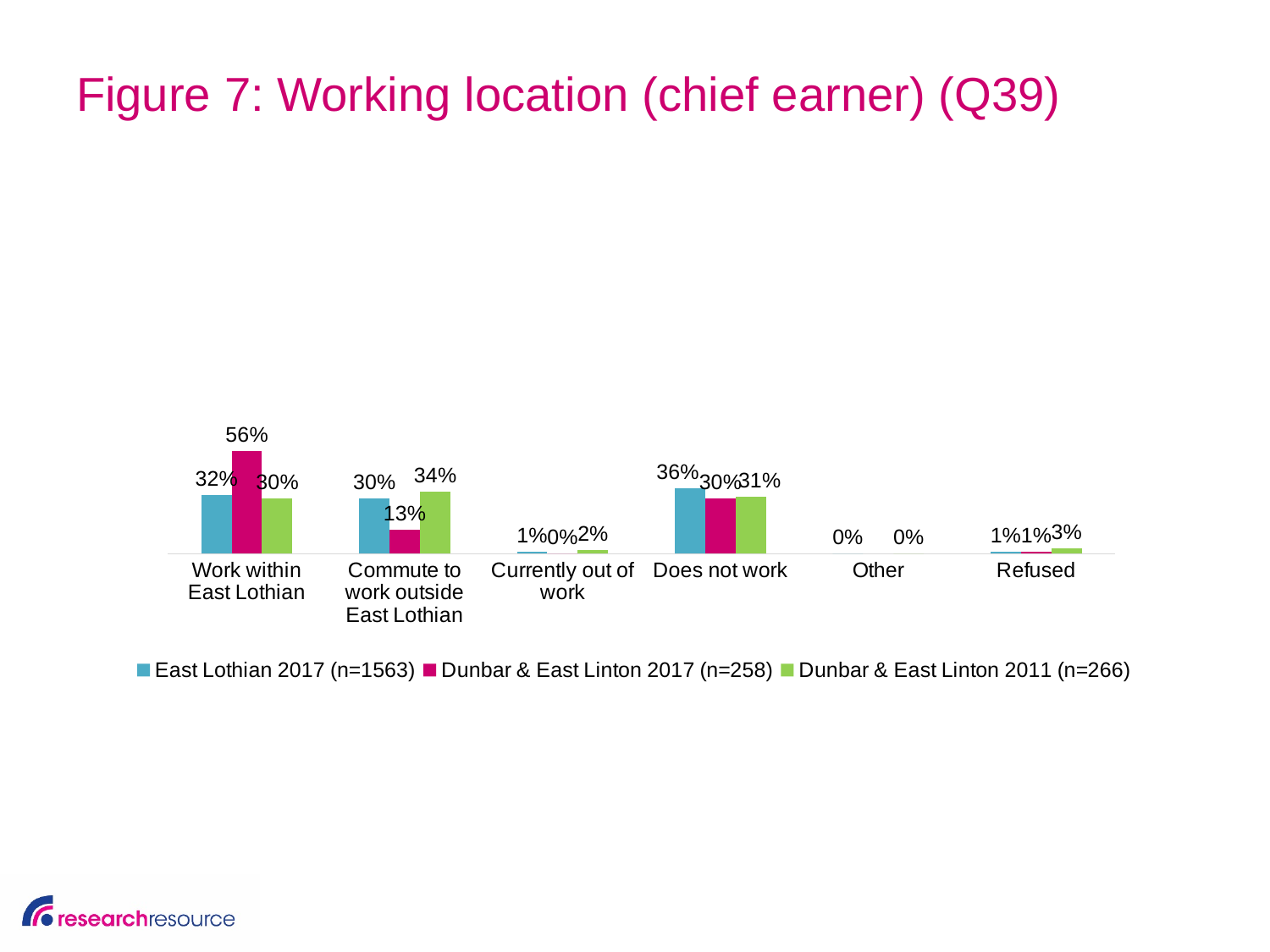
Which category has the highest value for East Lothian 2017 (n=1563)? Does not work Which category has the highest value for Dunbar & East Linton 2017 (n=258)? Work within East Lothian What is the value for Dunbar & East Linton 2011 (n=266) in the 'Commute to work outside East Lothian' category? 34% What is the value for Dunbar & East Linton 2017 (n=258) in the 'Work within East Lothian' category? 56% What type of chart is shown on the slide? bar chart What is the value for East Lothian 2017 (n=1563) in the 'Does not work' category? 36% How many series does the legend list? 3 What is the difference between the Dunbar & East Linton 2017 (n=258) and East Lothian 2017 (n=1563) values for 'Work within East Lothian'? 24% What is the value for Dunbar & East Linton 2017 (n=258) in the 'Commute to work outside East Lothian' category? 13% What is the value for Dunbar & East Linton 2011 (n=266) in the 'Refused' category? 3% In the 'Commute to work outside East Lothian' category, which is larger: East Lothian 2017 (n=1563) or Dunbar & East Linton 2017 (n=258)? East Lothian 2017 (n=1563) How many categories are shown on the x axis? 6